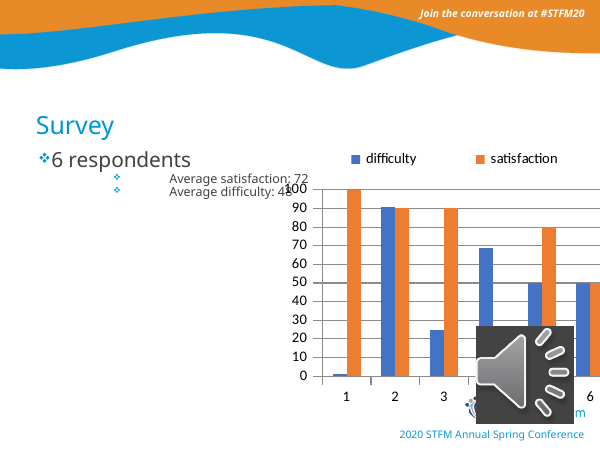
Is the difficulty value for category 1 greater or less than 10? less How many series does the legend list? 2 Which category has the lowest difficulty value? 1 For category 3, which is larger: difficulty or satisfaction? satisfaction What is the satisfaction value for category 1? 100 Is the difficulty value for category 3 greater or less than 40? less What kind of chart is shown on the slide? bar chart Which category has the highest difficulty value? 2 Is the difficulty value for category 4 greater or less than 60? greater How many categories are shown along the x axis? 6 What are the two series named in the legend? difficulty and satisfaction